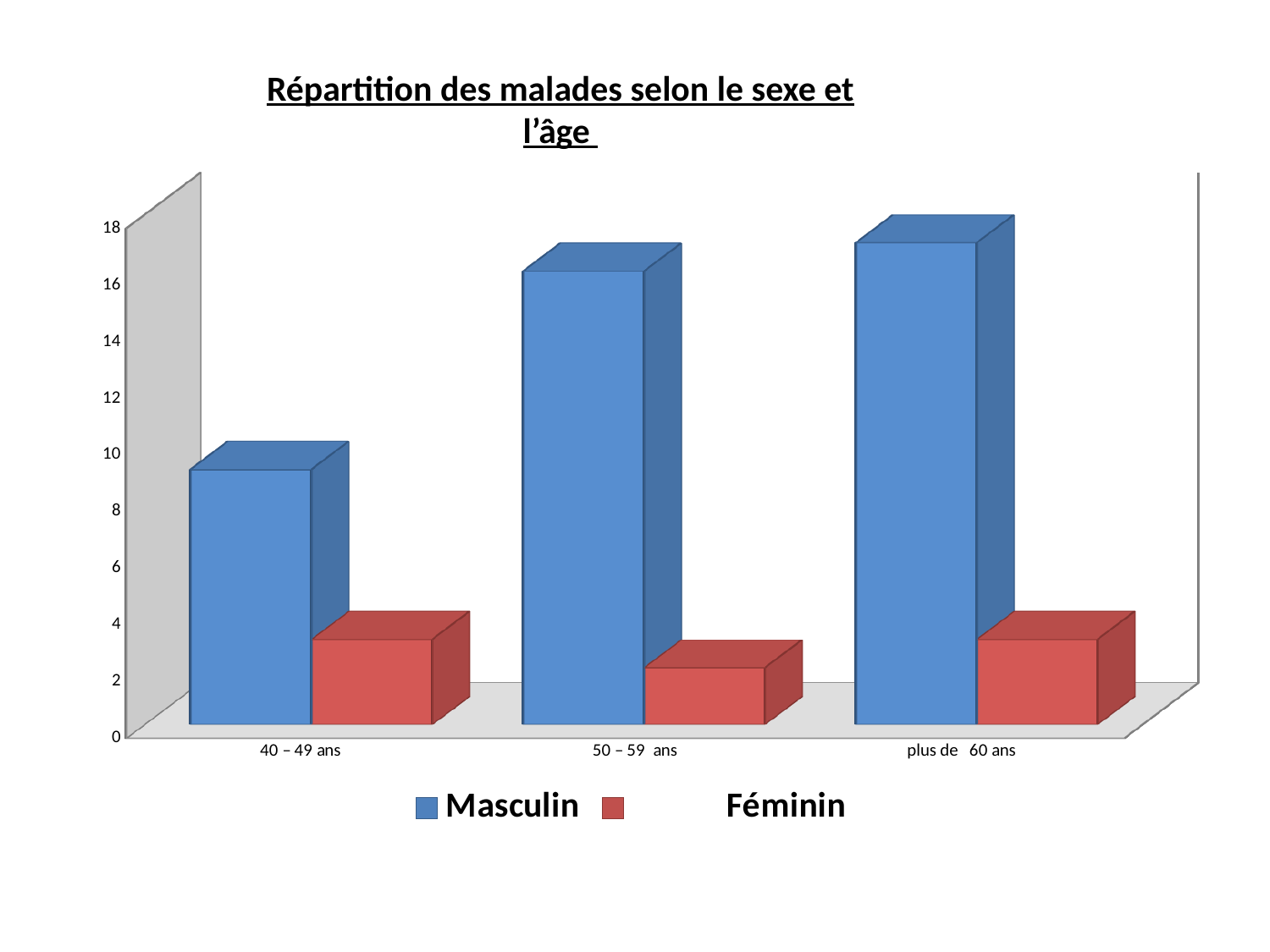
Is the Masculin value for 50 – 59 ans greater or less than 14? greater Is the Masculin value for 40 – 49 ans greater or less than 12? less Which colour represents the Féminin series? red How many series does the legend list? 2 How many age categories are shown on the x axis? 3 Is the Féminin value for plus de 60 ans greater or less than 6? less What kind of chart is shown on the slide? bar chart Which age category has the lowest Masculin value? 40 – 49 ans Which age category has the lowest Féminin value? 50 – 59 ans What is the title of the chart? Répartition des malades selon le sexe et l'âge Do the Masculin values rise or fall from 40 – 49 ans to plus de 60 ans? rise